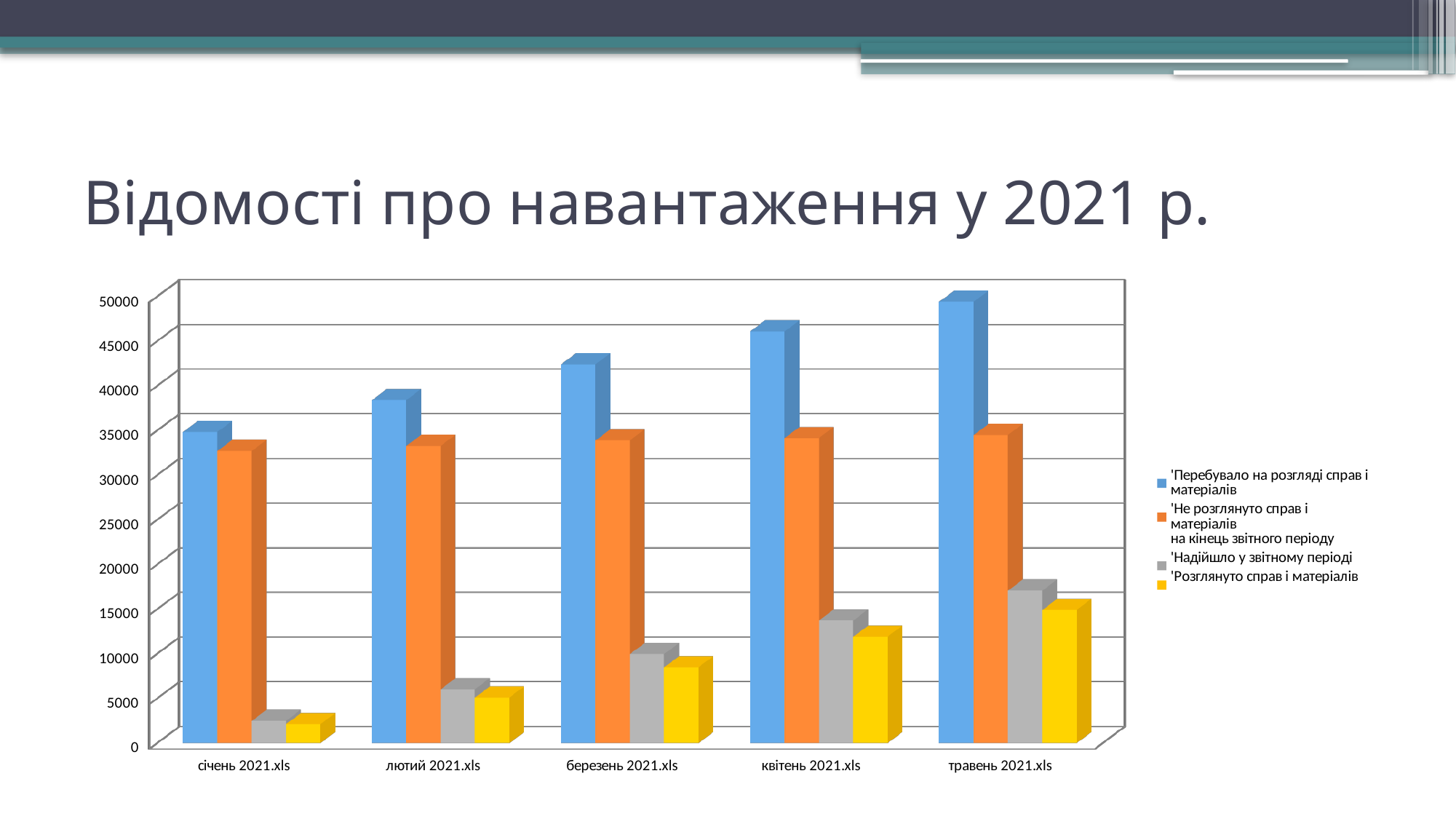
Is the value of 'Перебувало на розгляді справ і матеріалів' for січень 2021.xls greater or less than 40000? less Is the value of 'Надійшло у звітному періоді' for січень 2021.xls greater or less than 5000? less How many series does the chart's legend list? 4 Which category has the highest value for the series 'Перебувало на розгляді справ і матеріалів'? травень 2021.xls Is the value of 'Перебувало на розгляді справ і матеріалів' for травень 2021.xls greater or less than 45000? greater How many categories (months) are shown on the x axis of the chart? 5 Which category has the lowest value for the series 'Надійшло у звітному періоді'? січень 2021.xls Does the series 'Перебувало на розгляді справ і матеріалів' rise or fall from січень 2021.xls to травень 2021.xls? rise For травень 2021.xls, which is larger: 'Перебувало на розгляді справ і матеріалів' or 'Не розглянуто справ і матеріалів на кінець звітного періоду'? Перебувало на розгляді справ і матеріалів What kind of chart is shown on the slide? bar chart What is the title of the slide containing the chart? Відомості про навантаження у 2021 р.